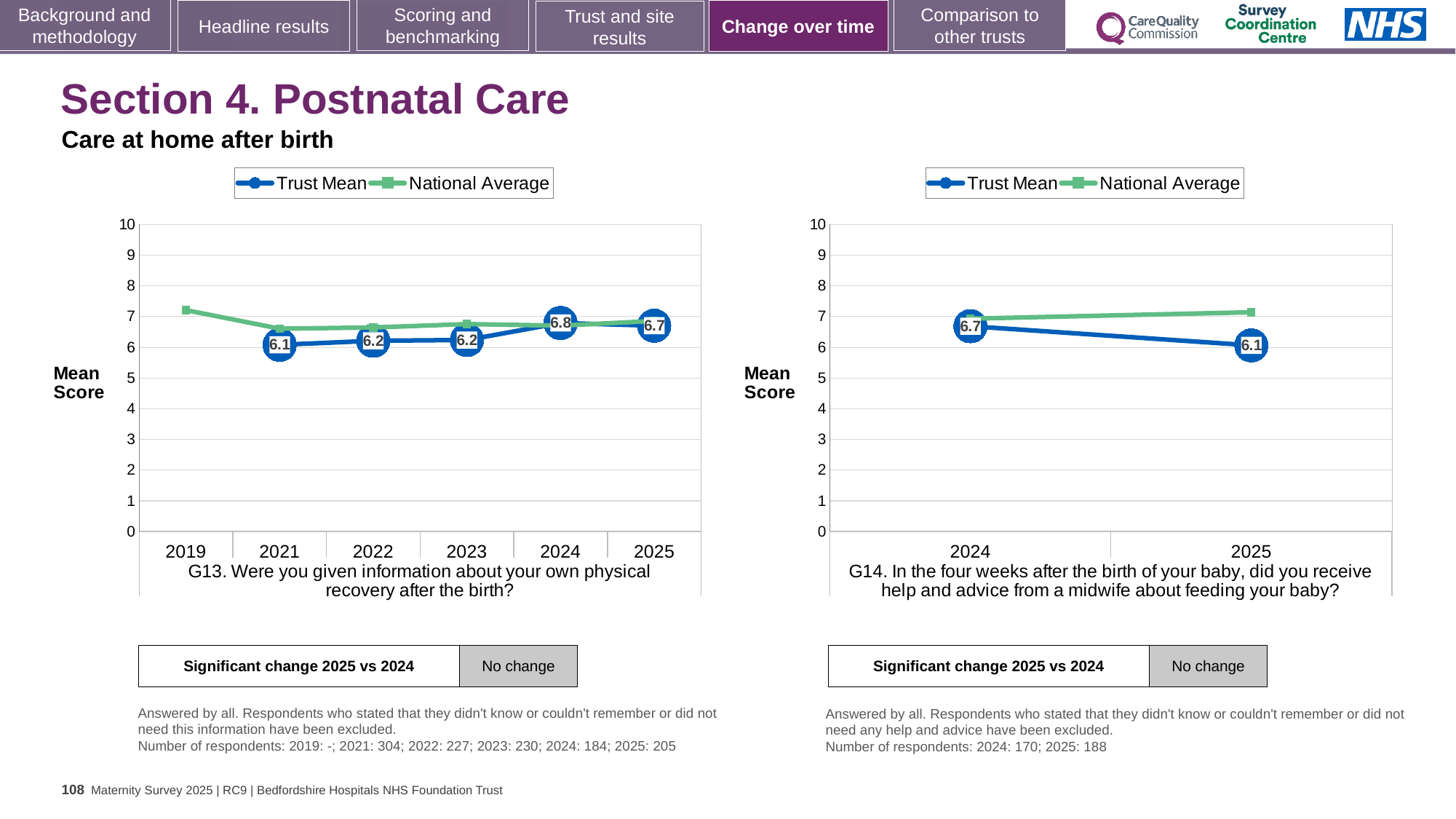
How many series does the legend of the G14 chart on the right list? 2 In the G13 chart on the left, what is the Trust Mean score for 2021? 6.1 In the G13 chart on the left, what is the Trust Mean score for 2024? 6.8 How many years are shown on the x axis of the G13 chart on the left? 6 In the G13 chart on the left, is the Trust Mean score higher in 2025 or in 2022? 2025 In the G13 chart on the left, which year has the lowest labelled Trust Mean score? 2021 In the G13 chart on the left, is the National Average value for 2019 greater or less than 6? greater In the G13 chart on the left, which year has the highest Trust Mean score? 2024 In the G14 chart on the right, does the Trust Mean rise or fall from 2024 to 2025? Fall In the G14 chart on the right, what is the difference between the Trust Mean scores for 2024 and 2025? 0.6 What kind of chart is the G14 chart on the right? Line chart In the G14 chart on the right, what is the Trust Mean score for 2025? 6.1